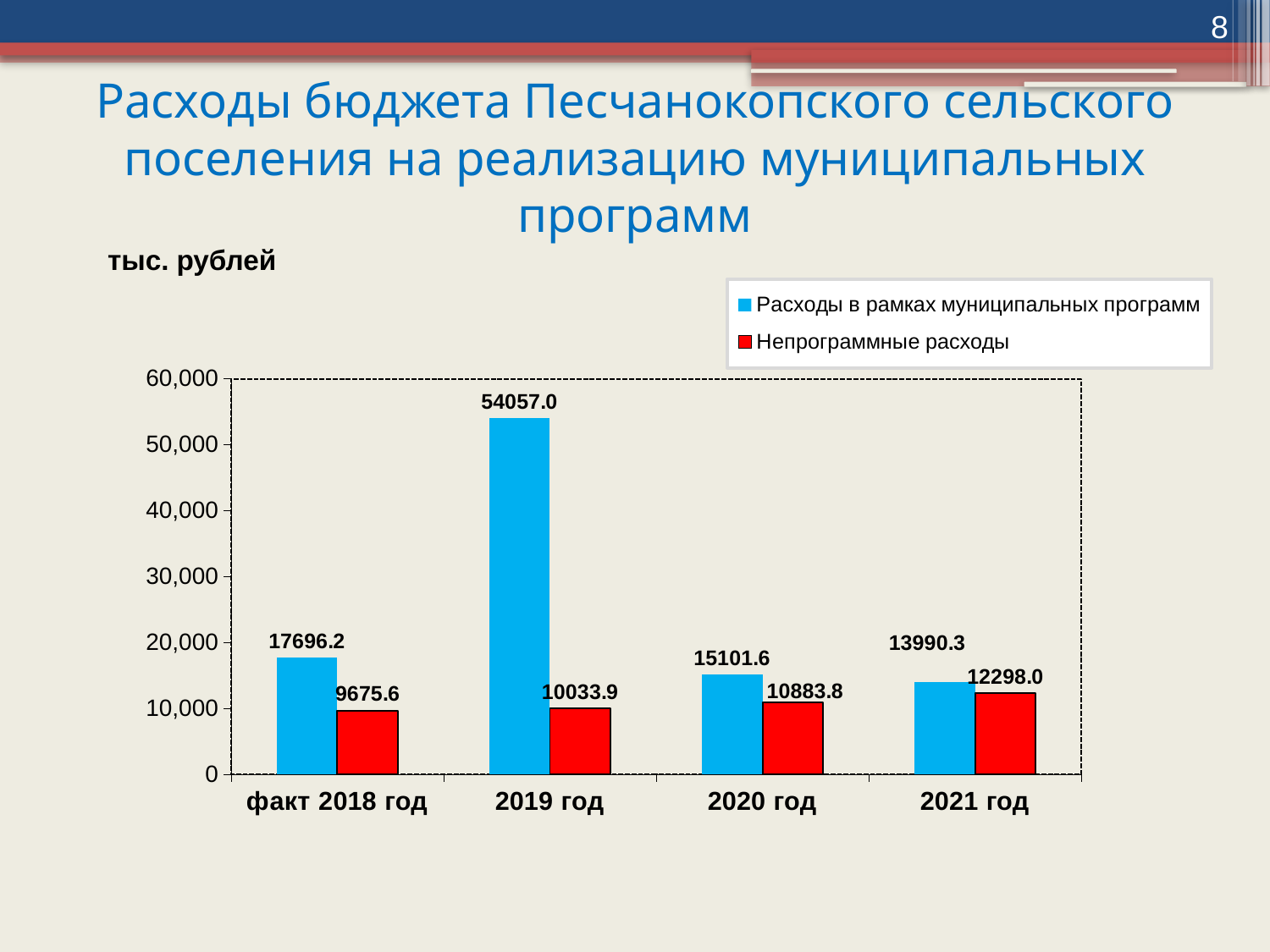
Is the value of 'Расходы в рамках муниципальных программ' for 2019 год greater or less than 50,000? greater How many series does the legend list? 2 What kind of chart is shown on the slide? bar chart What is the value of 'Непрограммные расходы' for факт 2018 год? 9675.6 Which is larger in 2020 год: 'Расходы в рамках муниципальных программ' or 'Непрограммные расходы'? Расходы в рамках муниципальных программ How many year categories are shown on the x axis? 4 In which year is 'Расходы в рамках муниципальных программ' highest? 2019 год What is the difference between 'Расходы в рамках муниципальных программ' and 'Непрограммные расходы' in 2021 год? 1692.3 What is the value of 'Расходы в рамках муниципальных программ' for 2019 год? 54057.0 What is the value of 'Непрограммные расходы' for 2021 год? 12298.0 What is the value of 'Расходы в рамках муниципальных программ' for 2020 год? 15101.6 In which year is 'Непрограммные расходы' lowest? факт 2018 год